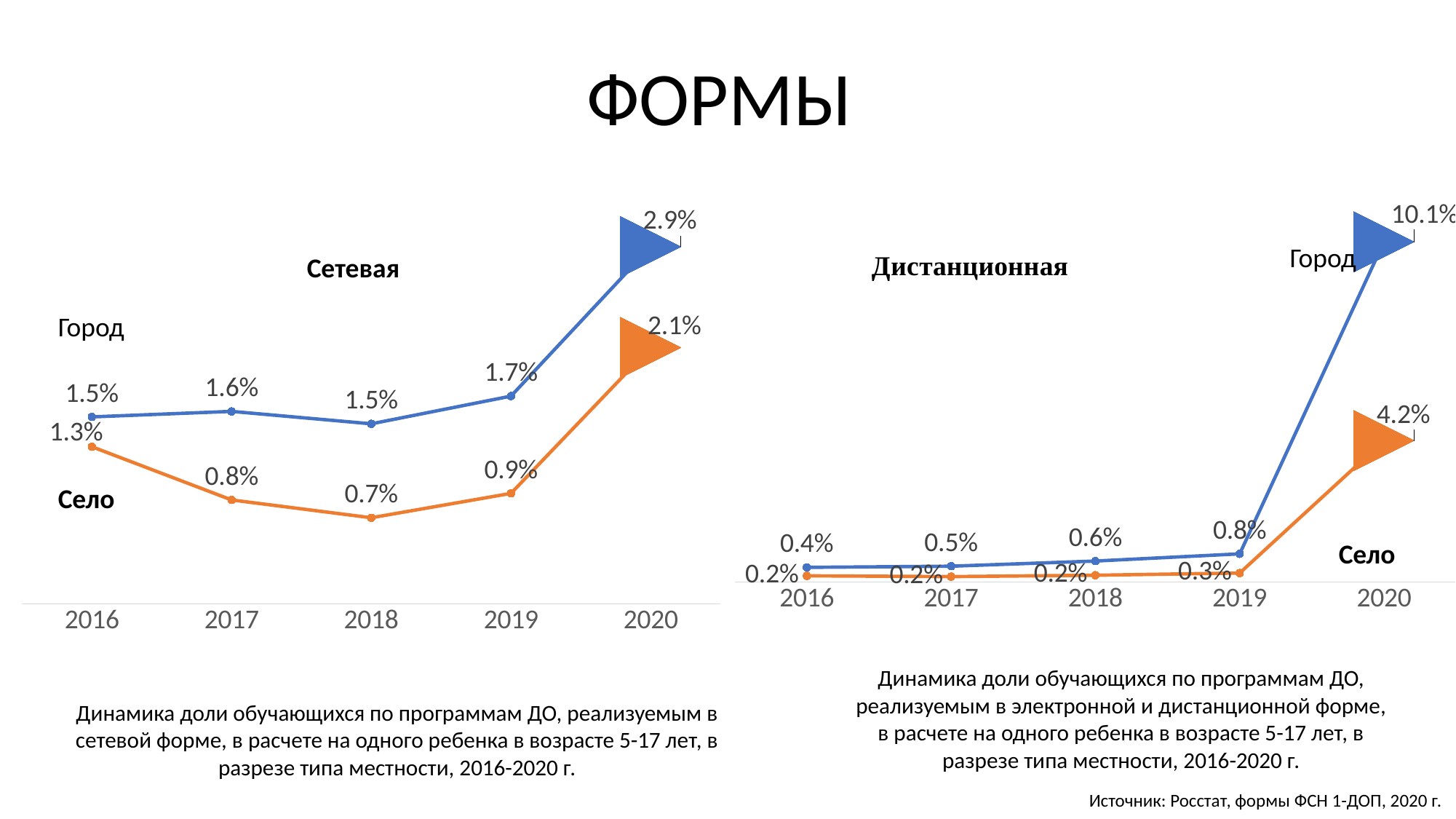
On the 'Сетевая' chart, what is the difference between Город and Село in 2016? 0.2% On the 'Дистанционная' chart, what is the value for Село in 2019? 0.3% On the 'Сетевая' chart, what is the value for Село in 2018? 0.7% What type of chart is the 'Сетевая' chart? Line chart On the 'Дистанционная' chart, does the Город value rise or fall from 2016 to 2020? Rise On the 'Дистанционная' chart, in which year is the Город value highest? 2020 On the 'Сетевая' chart, what is the value for Город in 2020? 2.9% On the 'Дистанционная' chart, what is the difference between Город and Село in 2020? 5.9% On the 'Дистанционная' chart, what is the value for Город in 2020? 10.1% On the 'Сетевая' chart, which is larger in 2019: Город or Село? Город On the 'Сетевая' chart, in which year is the Село value lowest? 2018 How many years are shown on the x axis of the 'Дистанционная' chart? 5